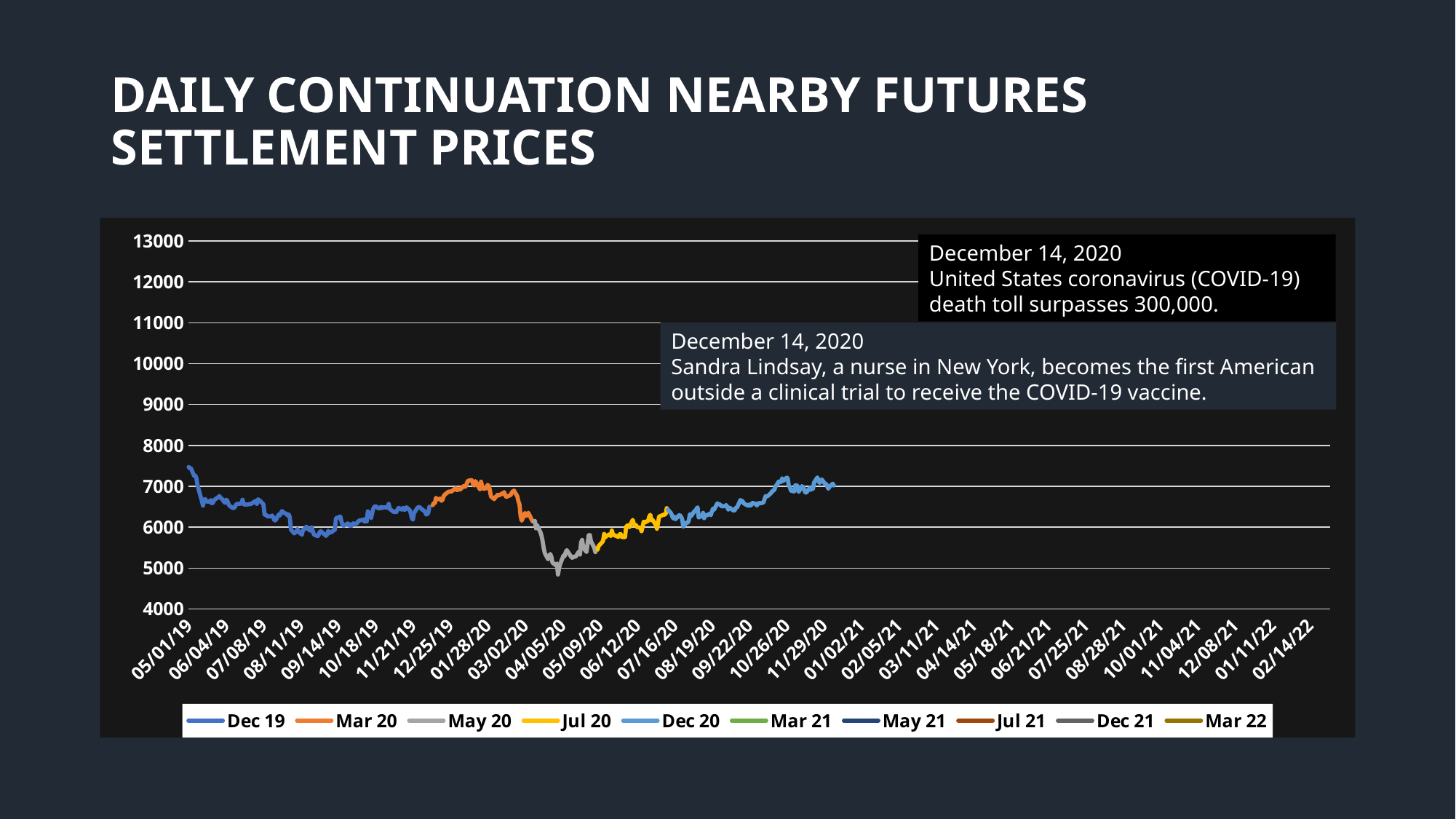
Is the highest point of the Dec 20 series greater or less than 6000? greater Is the highest point of the Jul 20 series greater or less than 7000? less What kind of chart is shown on the slide? Line chart Which series reaches a higher value: Dec 19 or Jul 20? Dec 19 Which series contains the lowest point plotted on the chart? May 20 What is the title of the chart on the slide? Daily Continuation Nearby Futures Settlement Prices Is the first plotted value of the Dec 19 series greater or less than 7000? greater How many series does the legend list? 10 Does the Dec 19 series generally rise or fall from its first point to its last point? fall What is the highest value shown on the vertical axis? 13000 Does the Dec 20 series generally rise or fall from its start to its end along the x axis? rise